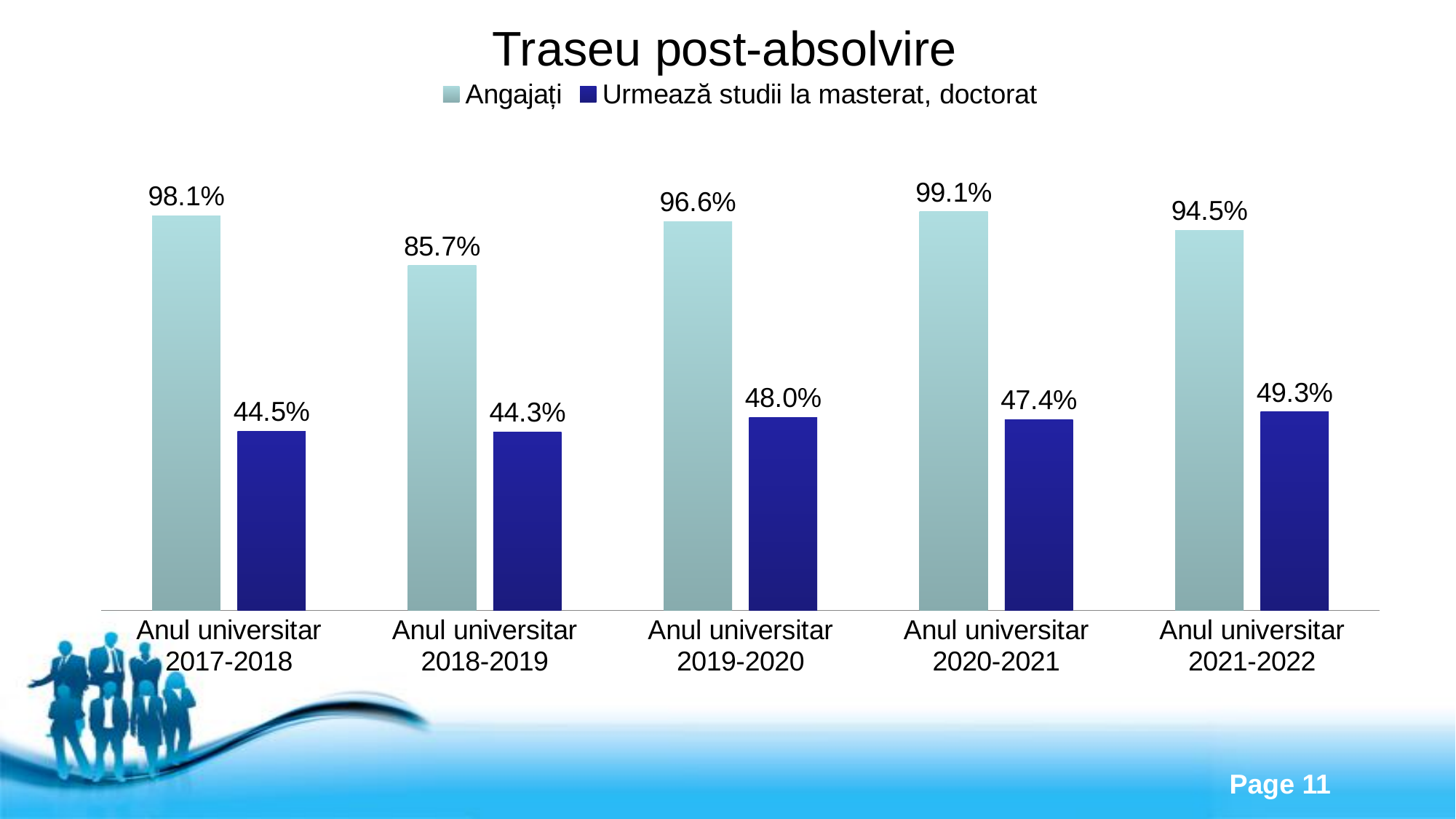
What kind of chart is shown on the slide? Bar chart Which academic year has the highest value for Angajați? Anul universitar 2020-2021 What is the value for Angajați in Anul universitar 2019-2020? 96.6% What is the value for Urmează studii la masterat, doctorat in Anul universitar 2021-2022? 49.3% Which academic year has the lowest value for Urmează studii la masterat, doctorat? Anul universitar 2018-2019 How many series does the legend list? 2 Which is larger: the Urmează studii la masterat, doctorat value for Anul universitar 2019-2020 or for Anul universitar 2020-2021? Anul universitar 2019-2020 Which academic year has the lowest value for Angajați? Anul universitar 2018-2019 How many academic years are shown on the x axis? 5 What is the value for Angajați in Anul universitar 2017-2018? 98.1% What is the title of the chart? Traseu post-absolvire What is the difference between the Angajați values for Anul universitar 2017-2018 and Anul universitar 2018-2019? 12.4%